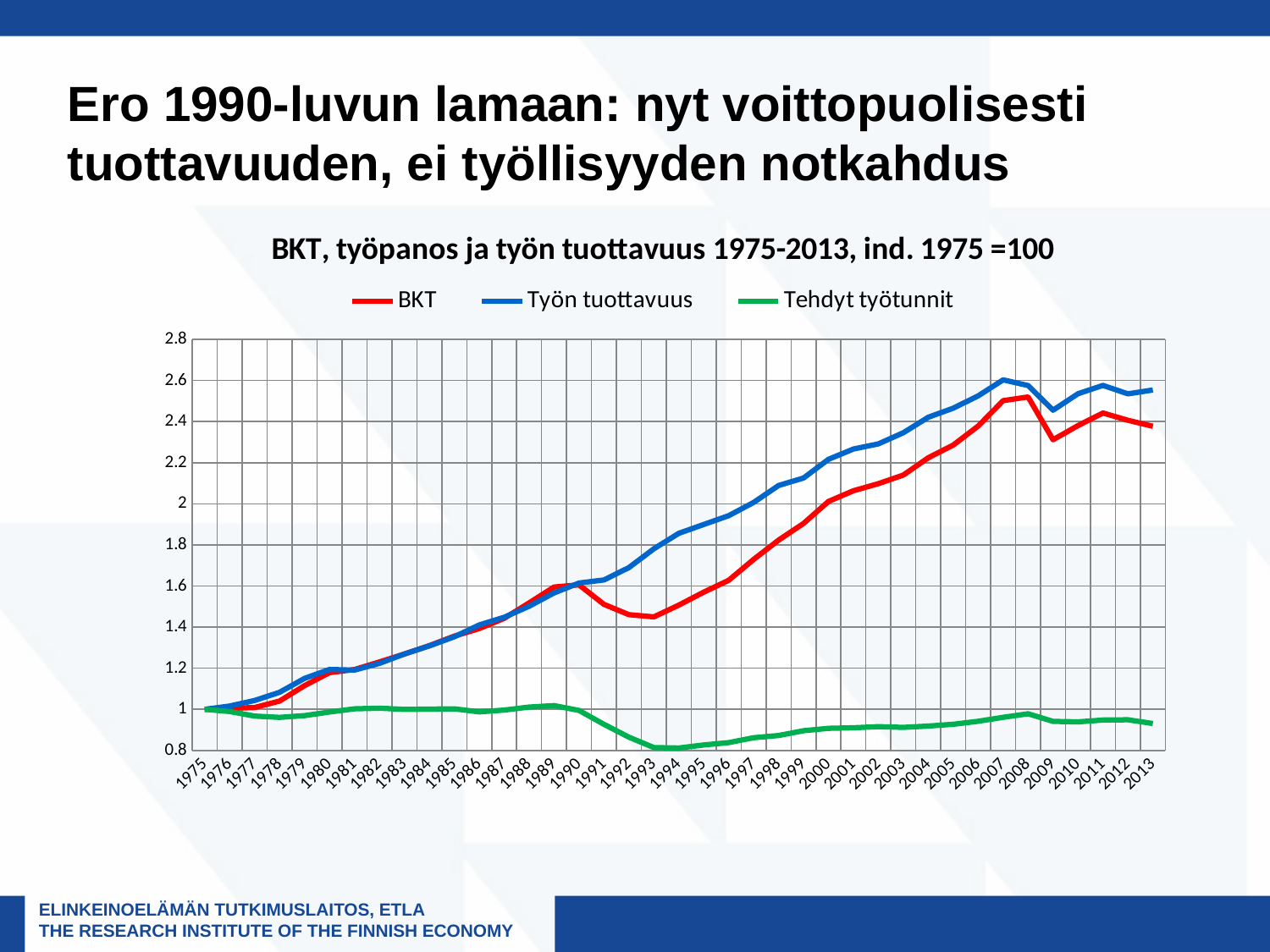
Is the value for Tehdyt työtunnit in 1994 greater or less than 1? less Which series has the lowest value in 2013? Tehdyt työtunnit In 2013, which is higher, BKT or Työn tuottavuus? Työn tuottavuus Is the value for BKT in 2005 greater or less than 2? greater How many series does the legend list? 3 Does the Työn tuottavuus line rise or fall from 1975 to 2007? rise What kind of chart is shown on the slide? line chart Is the value for BKT in 1993 greater or less than 1.6? less What colour is the BKT line? red Does the Tehdyt työtunnit line rise or fall from 1990 to 1994? fall How many years are labelled on the x axis? 39